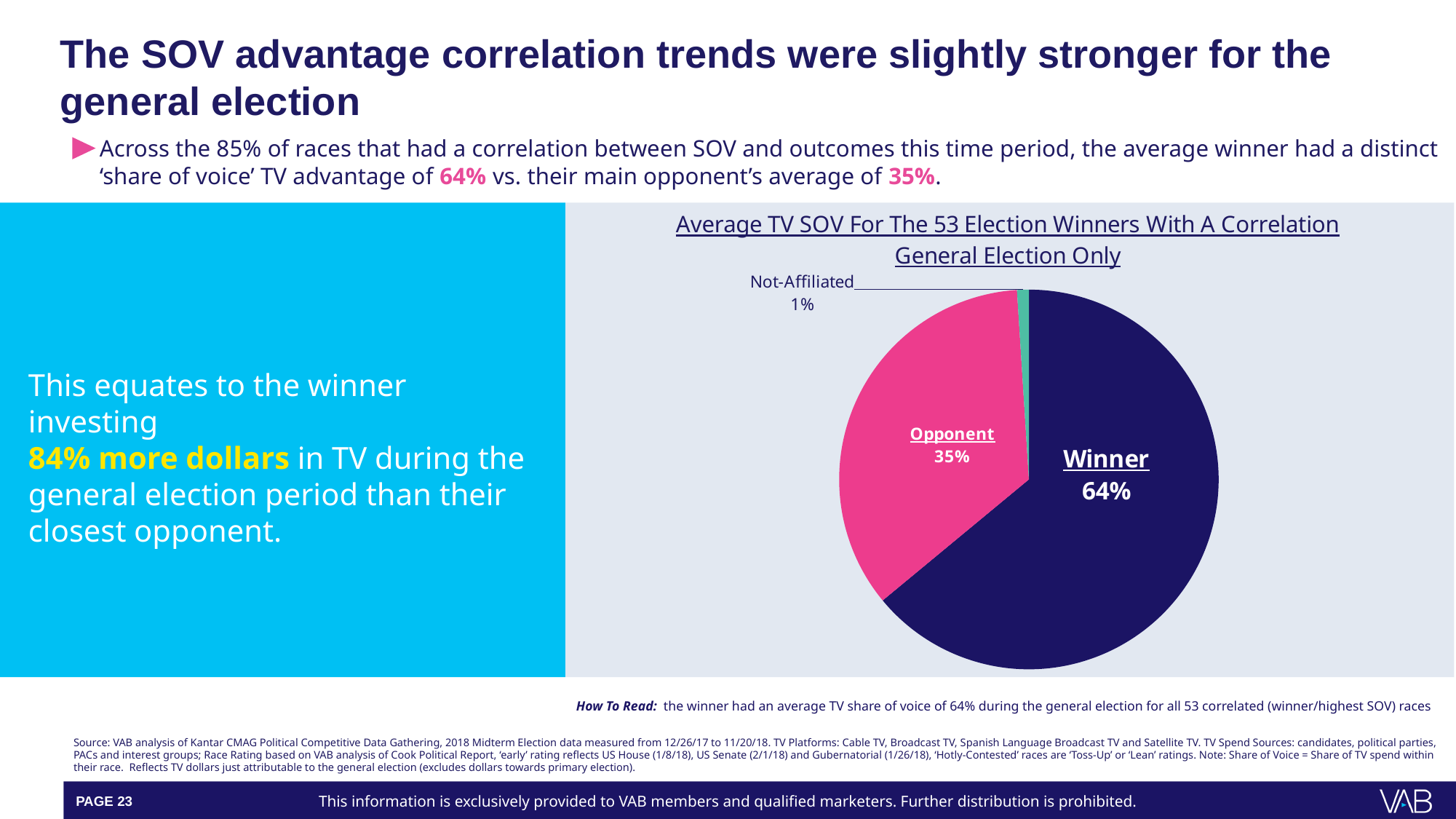
How many slices does the pie chart have? 3 What is the value of the Not-Affiliated slice? 1% What is the average TV SOV for the Opponent slice? 35% What colour is the Opponent slice of the pie chart? Pink Which slice of the pie is the largest? Winner Which slice of the pie is the smallest? Not-Affiliated Which is larger, the Opponent slice or the Not-Affiliated slice? Opponent What is the difference in percentage points between the Winner and Opponent slices? 29 What share of the pie does the Winner slice represent? 64% What kind of chart is shown on the slide? Pie chart What is the average TV SOV for the Winner slice? 64% What is the title of the pie chart? Average TV SOV For The 53 Election Winners With A Correlation General Election Only